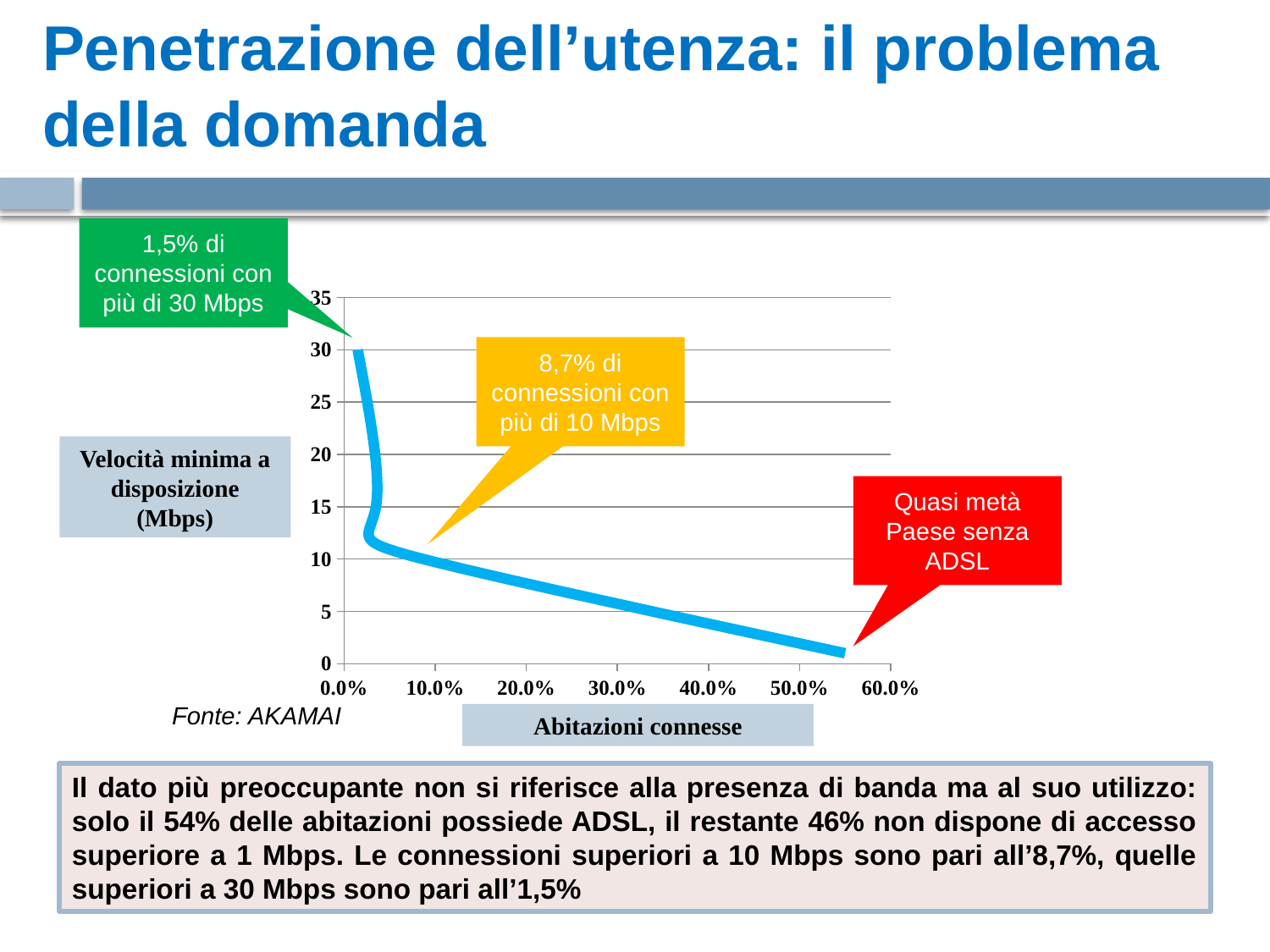
As the share of connected homes (Abitazioni connesse) increases along the x axis, does the minimum available speed rise or fall? fall What is the label of the x axis of the chart? Abitazioni connesse According to the callout on the chart, what percentage of connections have more than 10 Mbps? 8,7% At a minimum speed of 5 Mbps, is the share of connected homes greater or less than 20.0%? greater According to the callout on the chart, what percentage of connections have more than 30 Mbps? 1,5% At a minimum speed of 30 Mbps, is the share of connected homes greater or less than 10.0%? less At the lowest point of the curve (around 1 Mbps), is the share of connected homes greater or less than 50.0%? greater What source is cited for the chart? AKAMAI What kind of chart is shown on the slide? line chart